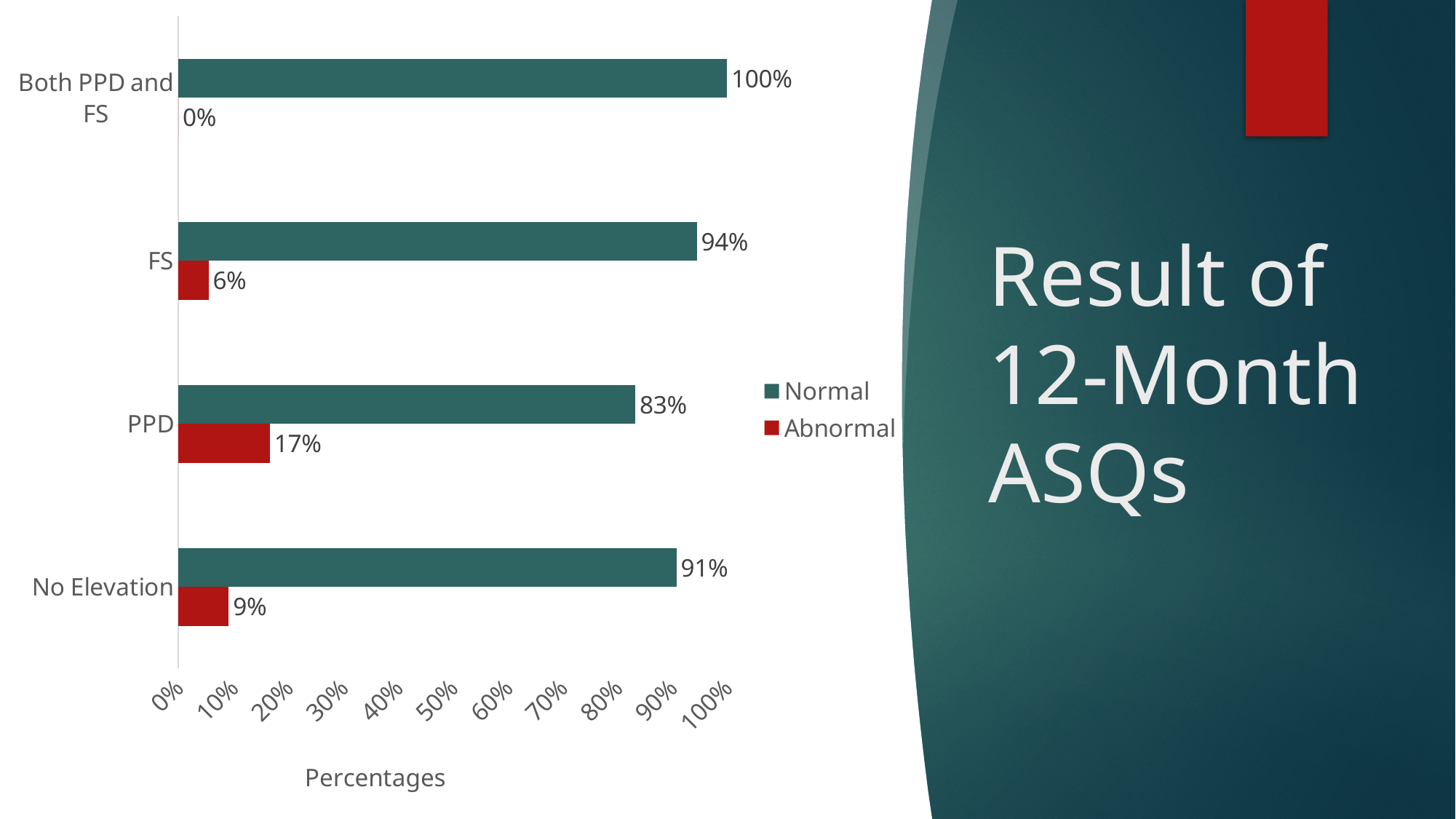
What is the Abnormal percentage for Both PPD and FS? 0% What is the Abnormal percentage for No Elevation? 9% Which category has the lowest Normal percentage? PPD What is the Normal percentage for PPD? 83% What is the difference between the Normal and Abnormal percentages for FS? 88% Which category has the highest Abnormal percentage? PPD Which is larger, the Abnormal percentage for PPD or for No Elevation? PPD How many series does the legend list? 2 What kind of chart is shown on the slide? Bar chart How many categories are shown on the chart? 4 What is the label of the x axis? Percentages Which category has the highest Normal percentage? Both PPD and FS